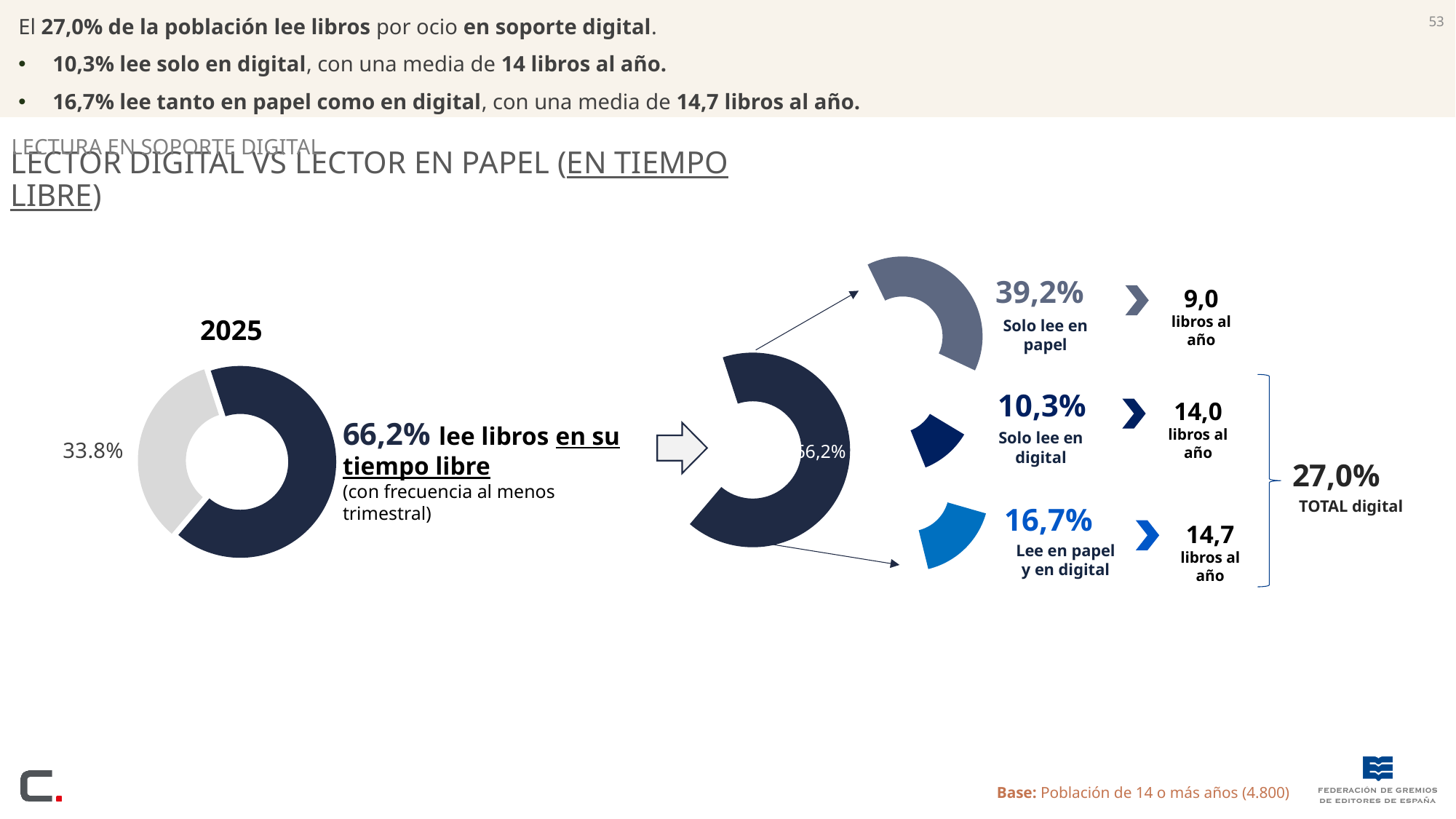
In the left donut chart labelled 2025, what value is shown for the grey segment? 33.8% What kind of chart is the 2025 chart on the left of the slide? Donut (pie) chart In the right-hand breakdown chart, how many books per year are read on average by those who 'Solo lee en papel'? 9,0 libros al año In the right-hand breakdown chart, what percentage corresponds to 'Solo lee en papel'? 39,2% In the right-hand breakdown chart, which reader category has the highest percentage? Solo lee en papel In the right-hand breakdown chart, what is the difference in percentage points between 'Solo lee en papel' and 'Lee en papel y en digital'? 22,5 points In the left donut chart labelled 2025, what percentage of the population reads books in their free time? 66,2% In the right-hand breakdown chart, what percentage corresponds to 'Solo lee en digital'? 10,3% In the right-hand breakdown chart, what is the combined 'TOTAL digital' percentage shown for the two digital categories? 27,0% In the right-hand breakdown chart, which is larger: 'Solo lee en digital' or 'Lee en papel y en digital'? Lee en papel y en digital In the right-hand breakdown chart, what percentage corresponds to 'Lee en papel y en digital'? 16,7% In the right-hand breakdown chart, which reader category has the lowest percentage? Solo lee en digital